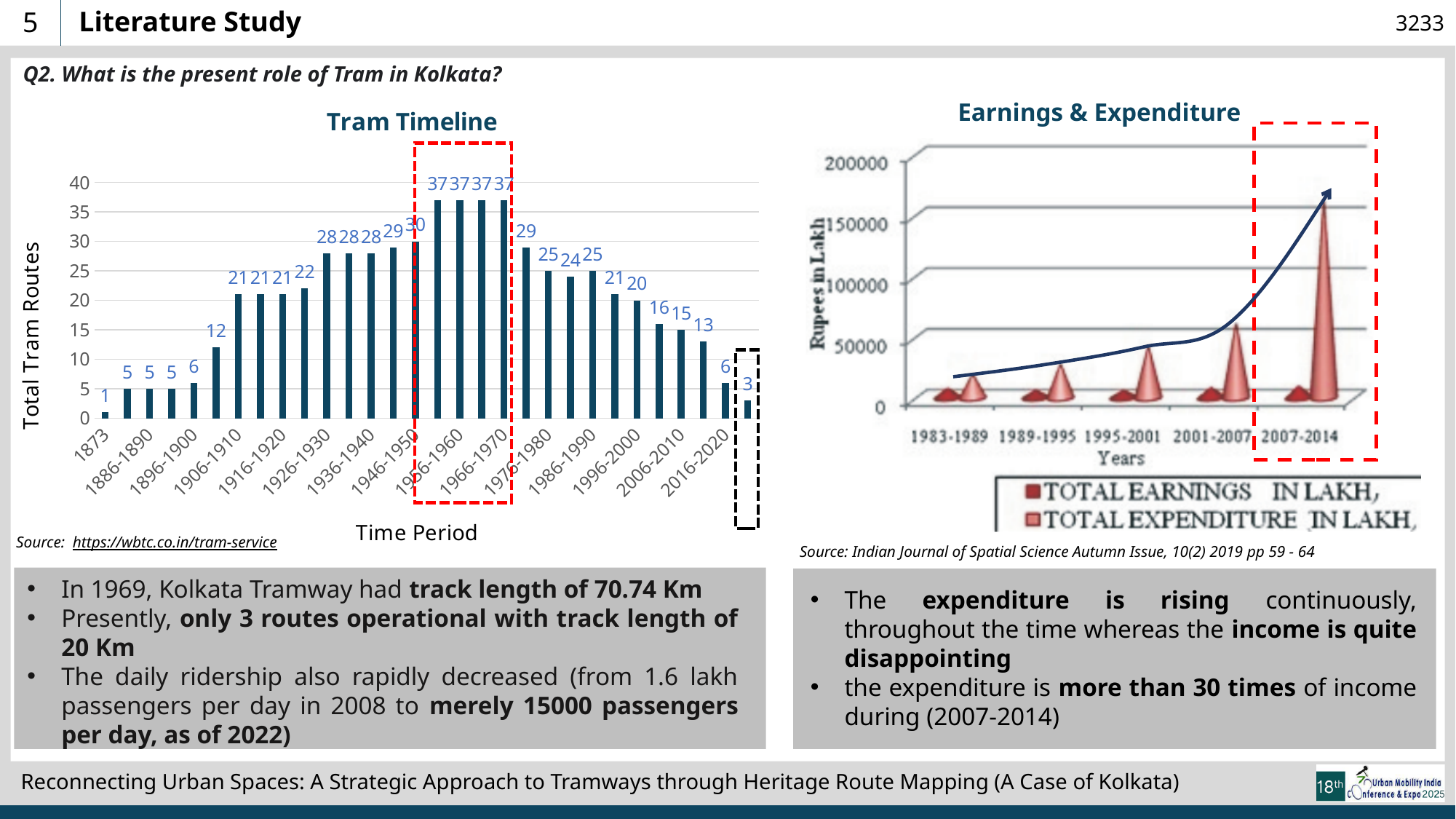
In the Tram Timeline chart, what is the highest number of tram routes shown? 37 In the Tram Timeline chart, what is the value of the last (rightmost) bar? 3 In the Earnings & Expenditure chart, which period has the highest total expenditure? 2007-2014 What kind of chart is the Tram Timeline chart? bar chart How many bars are plotted in the Tram Timeline chart? 30 In the Tram Timeline chart, what is the value for 1873? 1 In the Tram Timeline chart, do the values rise or fall from the 1966-1970 period to the 2016-2020 period? fall In the Tram Timeline chart, what is the difference between the highest value (37) and the value for 1873? 36 What is the y-axis label of the Tram Timeline chart? Total Tram Routes How many year periods are shown on the x-axis of the Earnings & Expenditure chart? 5 In the Earnings & Expenditure chart, is the total expenditure for 2007-2014 greater or less than 150000? greater How many series does the legend of the Earnings & Expenditure chart list? 2